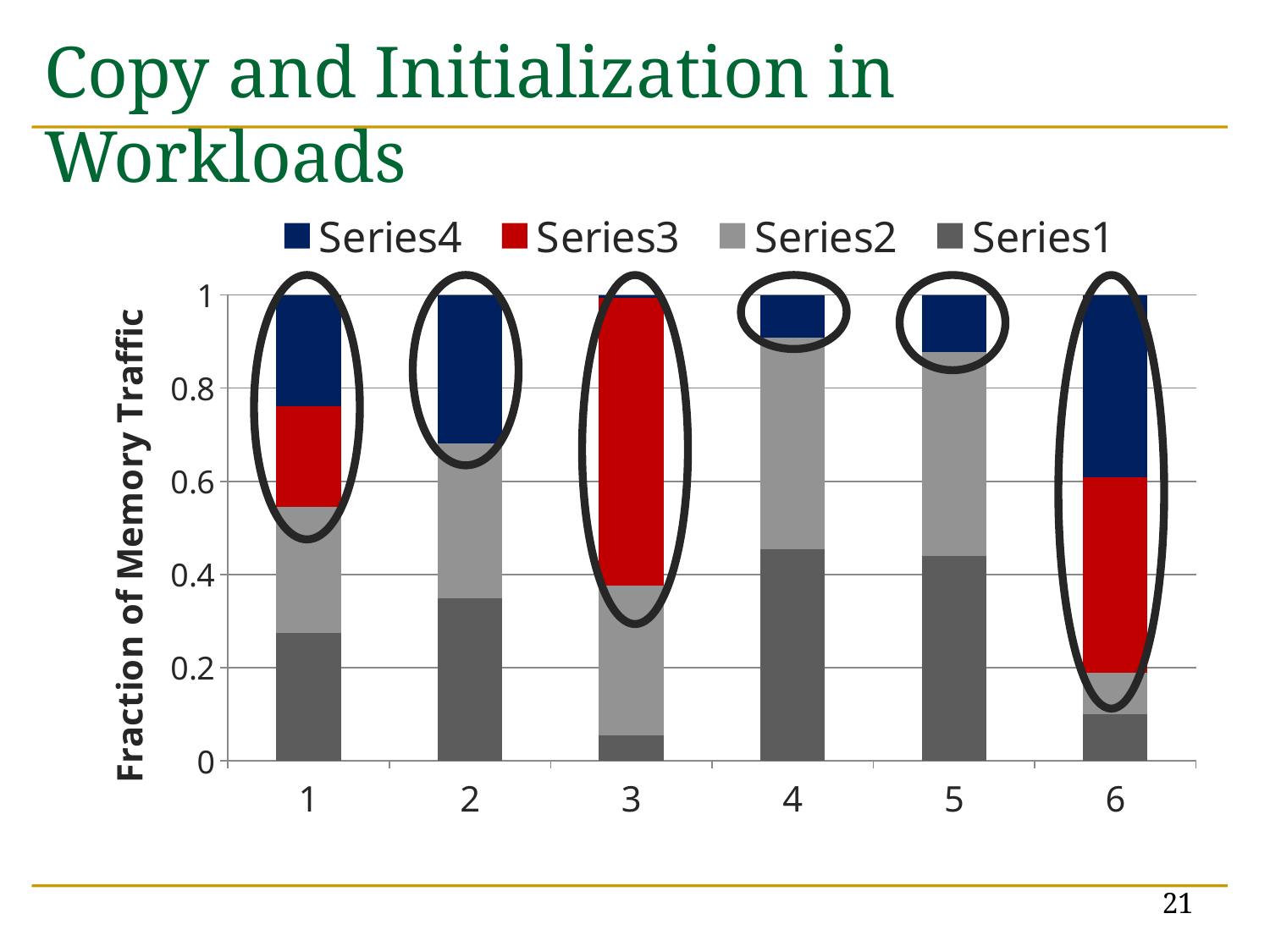
Which category has the largest Series3 segment? 3 How many series does the legend list? 4 How many categories are shown along the x axis? 6 What kind of chart is shown on the slide? Stacked bar chart Which category has the smallest Series1 segment? 3 Is the Series1 value for category 3 greater or less than 0.2? less Which is larger, the Series1 value for category 1 or for category 2? Category 2 What is the title of the y axis? Fraction of Memory Traffic What is the total height of the stacked bar for category 1? 1 Is the Series1 value for category 4 greater or less than 0.4? greater Is the Series1 value for category 6 greater or less than 0.2? less What colour represents Series3 in the legend? Red